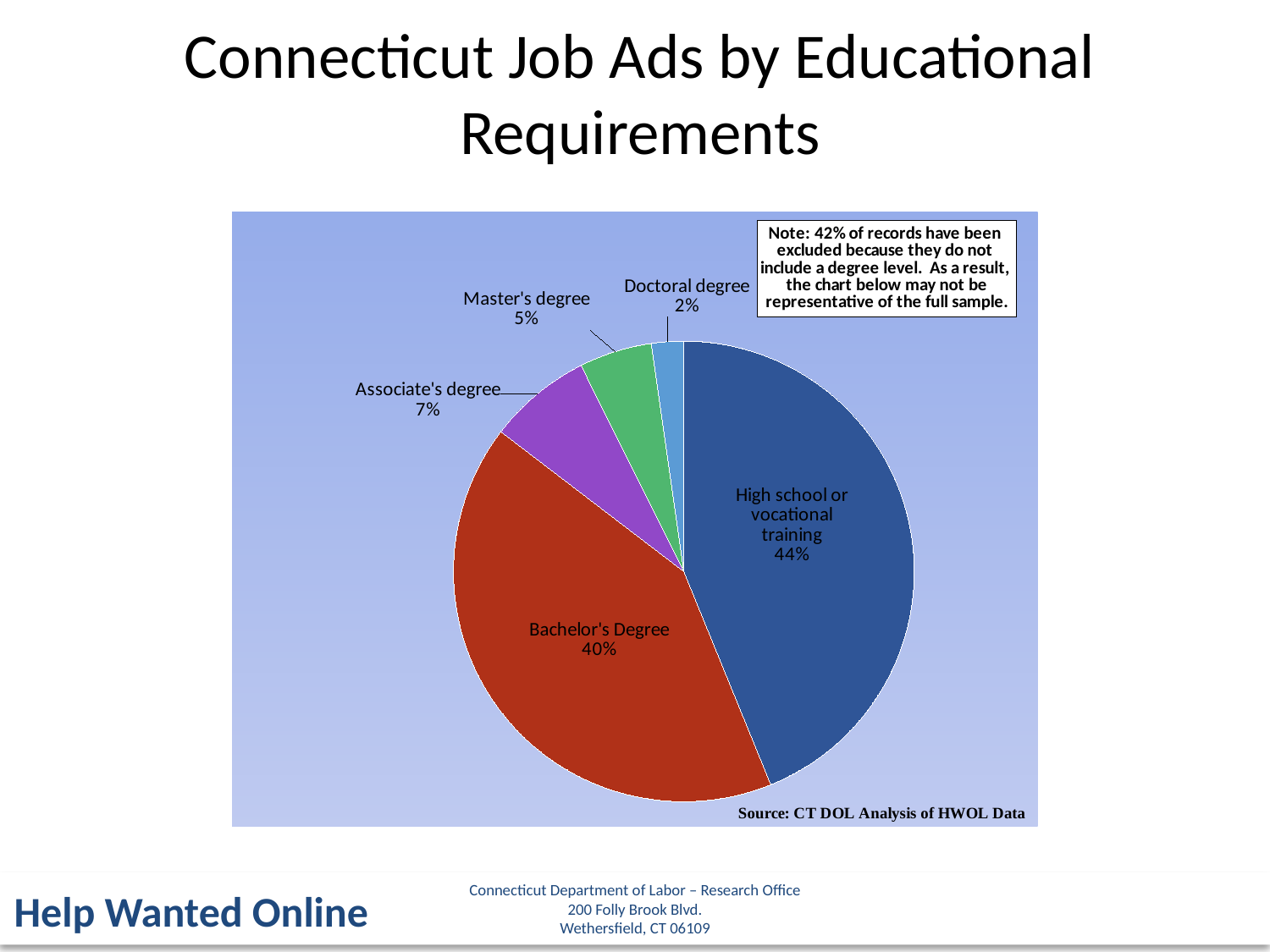
What is the difference in percentage points between High school or vocational training and Bachelor's Degree? 4 According to the note on the chart, what percentage of records have been excluded? 42% What percentage of job ads require a Doctoral degree? 2% Which educational requirement has the largest share of job ads? High school or vocational training What percentage of job ads require a Master's degree? 5% What kind of chart is shown on the slide? pie chart What share of job ads require High school or vocational training? 44% What share of Connecticut job ads require a Bachelor's Degree? 40% How many slices does the pie chart have? 5 Which has a larger share of job ads, Associate's degree or Master's degree? Associate's degree What percentage of job ads require an Associate's degree? 7% Which educational requirement has the smallest share of job ads? Doctoral degree